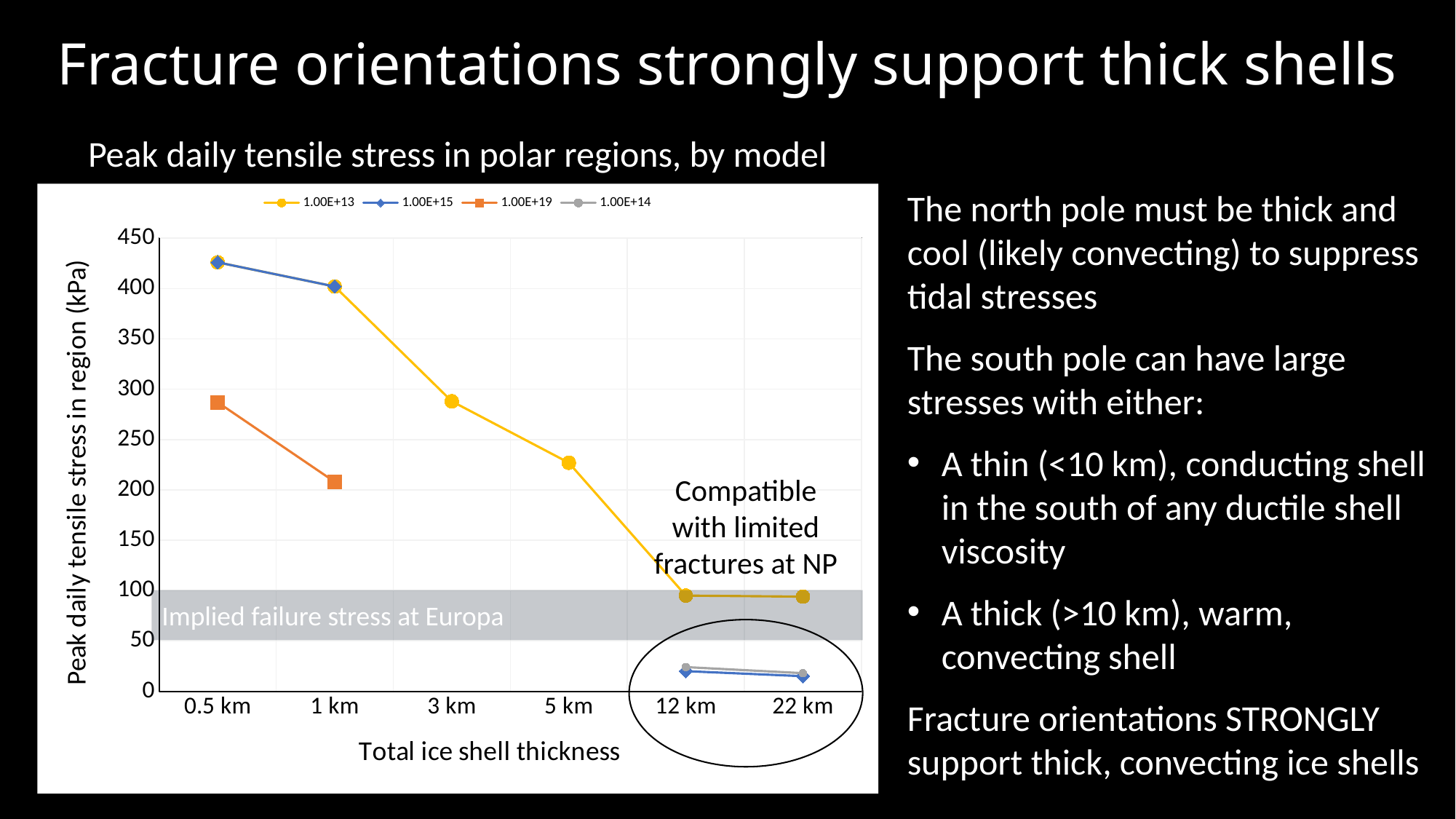
Is the value for the 1.00E+19 series at 1 km greater or less than 250? less What kind of chart is shown on the slide? line chart At 0.5 km, which series has the larger value: 1.00E+13 or 1.00E+19? 1.00E+13 At which total ice shell thickness does the 1.00E+13 series reach its highest value? 0.5 km Is the value for the 1.00E+13 series at 5 km greater or less than 200? greater How many series does the chart legend list? 4 Is the value for the 1.00E+13 series at 12 km greater or less than 150? less What is the title of the chart's y axis? Peak daily tensile stress in region (kPa) Does the 1.00E+13 series rise or fall as total ice shell thickness increases? fall How many ice shell thickness categories are shown on the x axis? 6